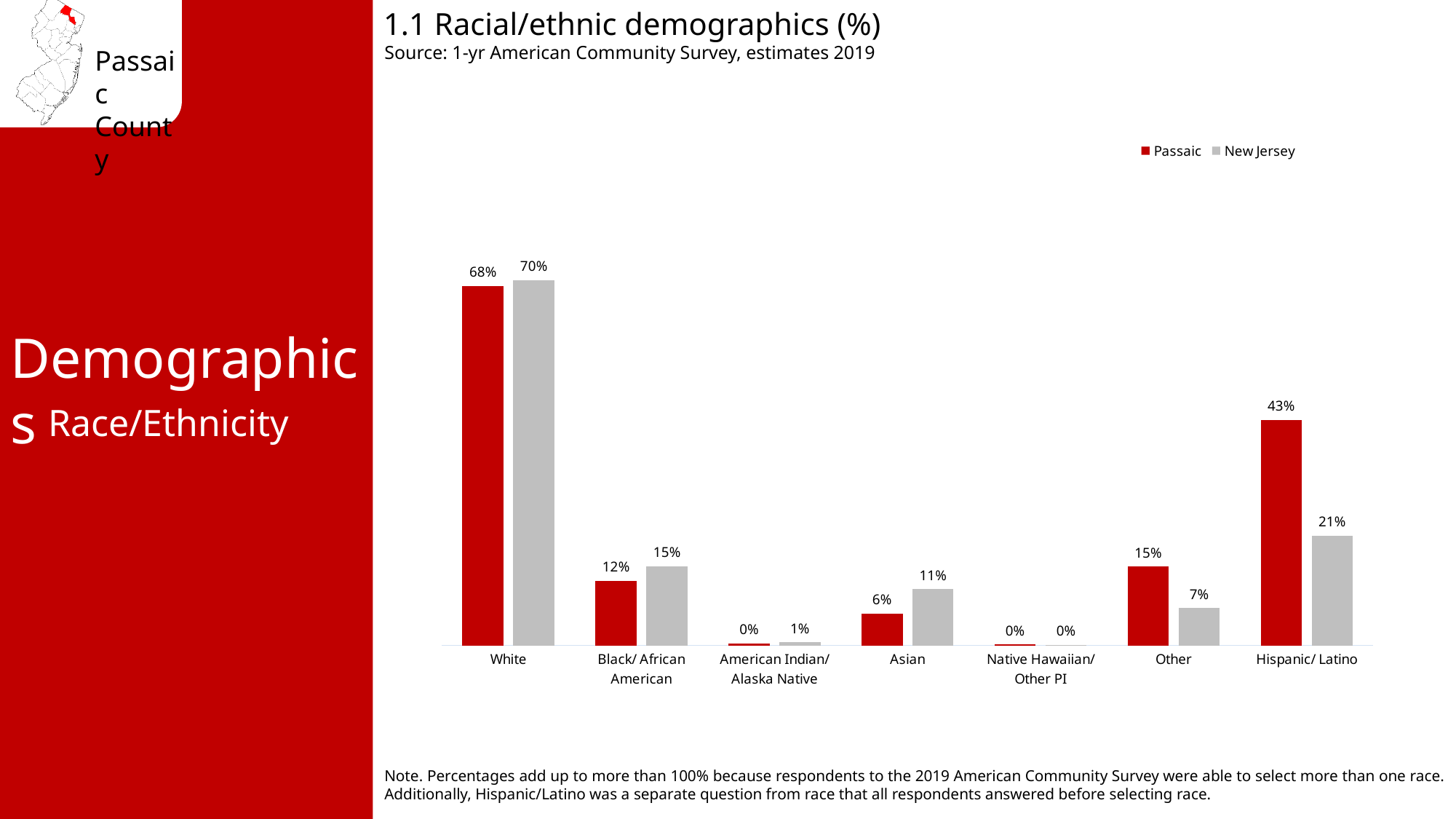
Which is larger for Other, the Passaic value or the New Jersey value? Passaic What kind of chart is shown? Bar chart What is the New Jersey value for Hispanic/ Latino? 21% What is the Passaic value for Other? 15% What is the difference between the Passaic and New Jersey values for Hispanic/ Latino? 22% Which is larger for Asian, the Passaic value or the New Jersey value? New Jersey What is the difference between the New Jersey and Passaic values for Black/ African American? 3% How many categories are shown on the x axis? 7 What is the Passaic value for White? 68% Which category has the highest Passaic value? White What is the New Jersey value for Asian? 11% How many series does the legend list? 2